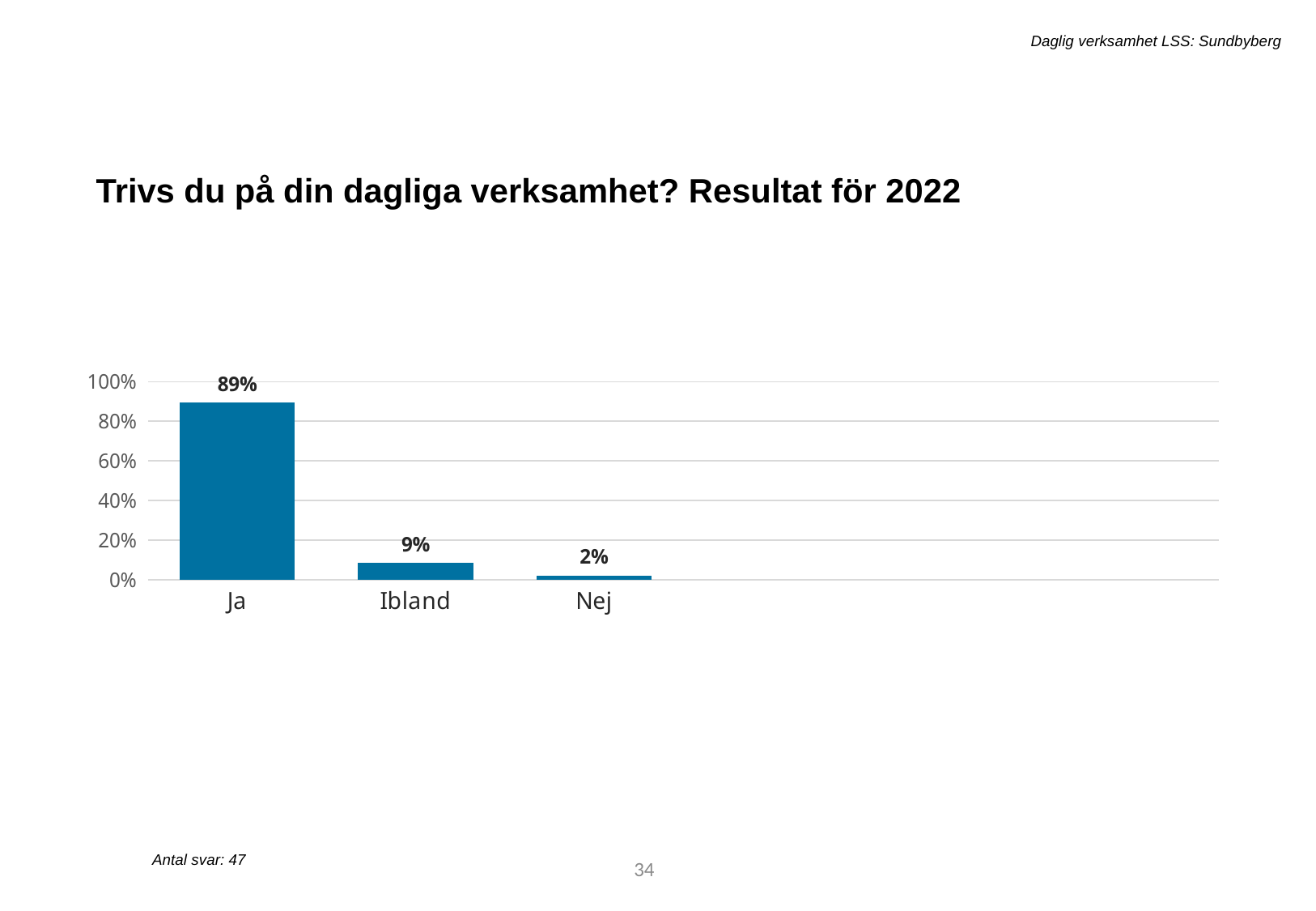
What is the title of the slide? Trivs du på din dagliga verksamhet? Resultat för 2022 What is the value for Ibland? 9% What is the difference between the values for Ibland and Nej? 7% Which category has the lowest value? Nej What is the difference between the values for Ja and Ibland? 80% How many categories are shown on the x axis? 3 Is the value for Ja greater or less than 80%? greater Which category has the highest value? Ja What kind of chart is shown on the slide? bar chart Which is larger, the value for Ibland or the value for Nej? Ibland What is the value for Nej? 2% What is the value for Ja? 89%